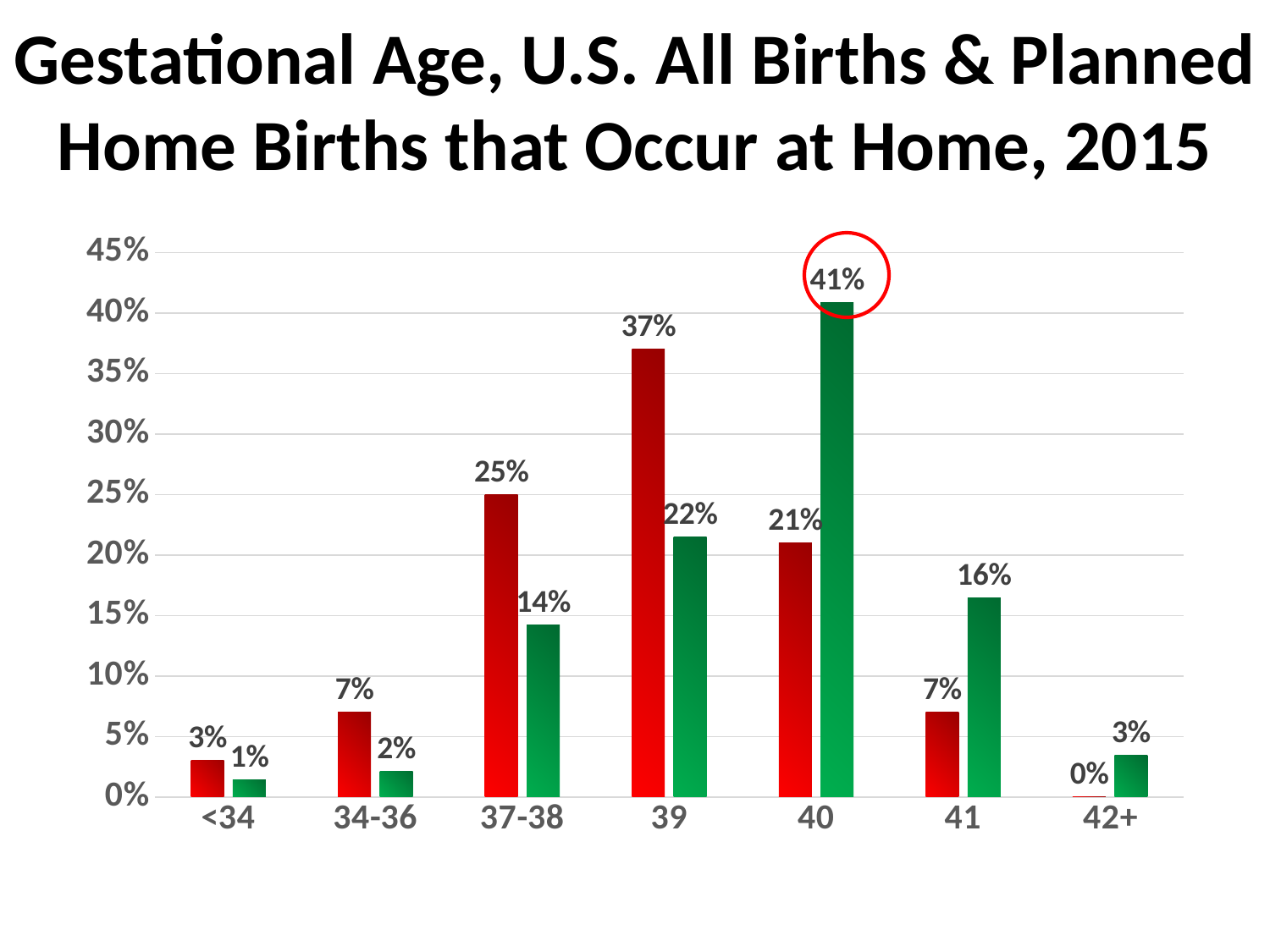
What is the value of the red bar for the 39 category? 37% What is the value of the green bar for the 37-38 category? 14% Which data label on the chart is circled in red? 41% What is the value of the green bar for the 40 category? 41% What is the value of the red bar for the 42+ category? 0% For the 41 category, which is larger, the red bar or the green bar? the green bar Which category has the highest red bar? 39 What kind of chart is shown on the slide? bar chart How many gestational age categories are shown on the x axis? 7 Which category has the highest green bar? 40 Which category has the lowest green bar? <34 What is the difference between the red bar and the green bar for the 40 category? 20%